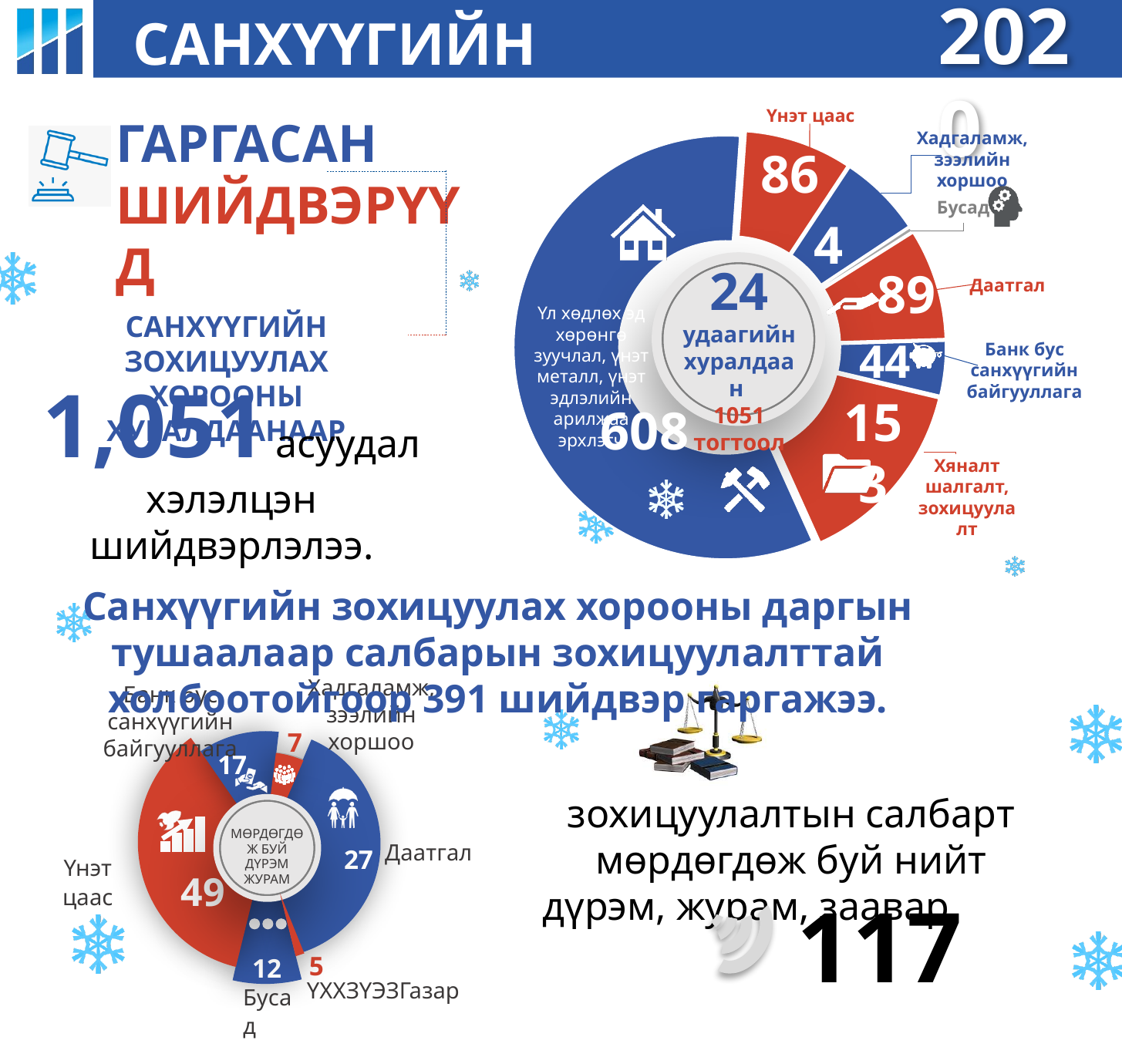
In the top chart, which category has the largest value? Үл хөдлөх эд хөрөнгө зуучлал, үнэт металл, үнэт эдлэлийн арилжаа эрхлэгч In the bottom chart, which category has the smallest value? ҮХХЗҮЭЗГазар In the top chart, what is the value for Банк бус санхүүгийн байгууллага? 44 In the top chart, what is the value for Үнэт цаас? 86 What kind of chart is the bottom chart? Pie (donut) chart In the bottom chart, what is the value for Үнэт цаас? 49 In the bottom chart, what is the difference between the values for Үнэт цаас and Бусад? 37 In the bottom chart, what is the value for Даатгал? 27 In the top chart, which is larger: Банк бус санхүүгийн байгууллага or Хадгаламж, зээлийн хоршоо? Хадгаламж, зээлийн хоршоо In the bottom chart, how many categories are shown? 6 In the top chart, what is the difference between the values for Даатгал and Үнэт цаас? 3 In the top chart, what is the value for Даатгал? 89